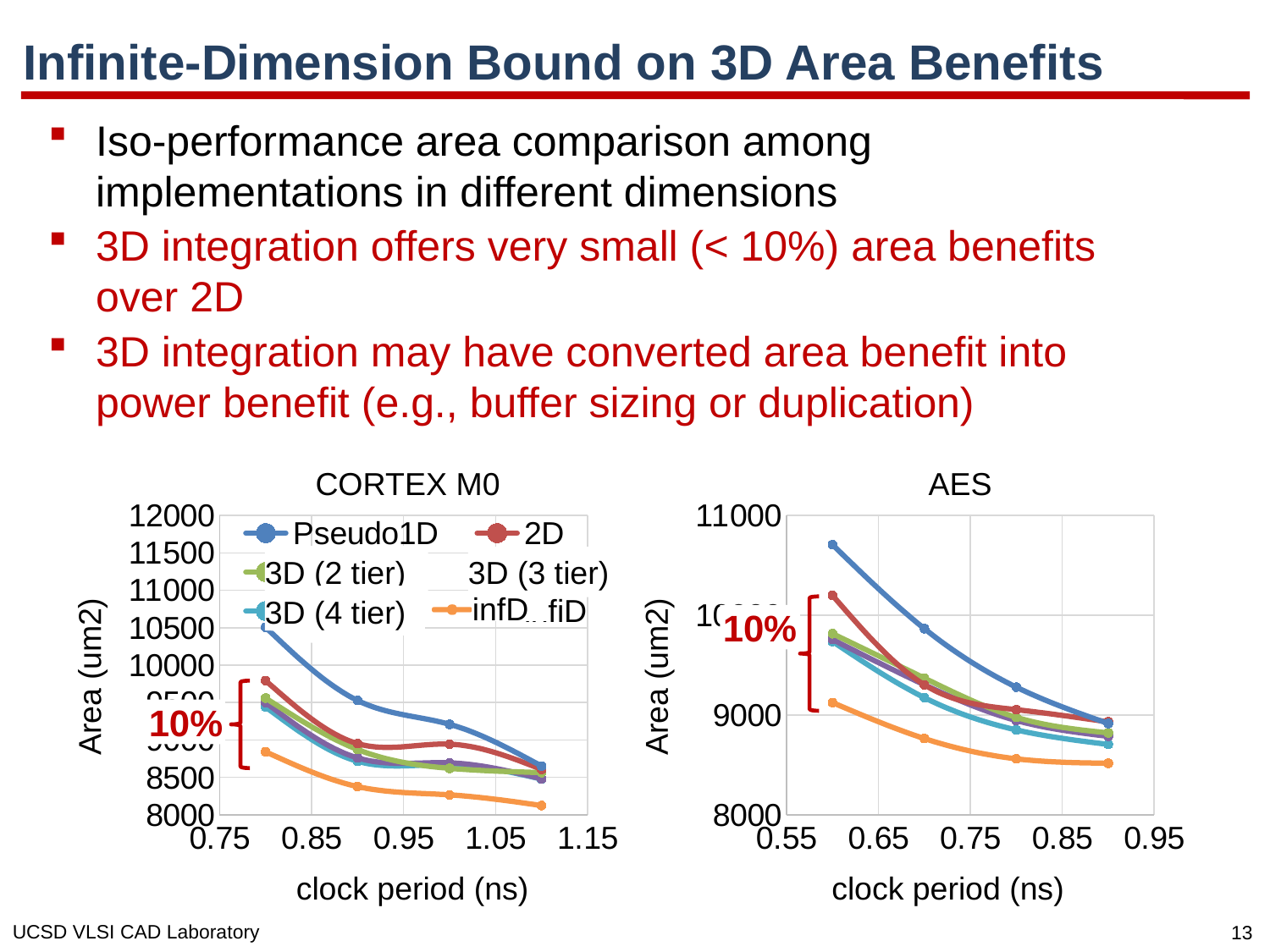
How many series does the legend on the CORTEX M0 chart list? 6 In the CORTEX M0 chart, which series has the highest area at every clock period? Pseudo1D In the CORTEX M0 chart, at a clock period of 0.9 ns, which series has the larger area: Pseudo1D or infD? Pseudo1D In the AES chart, how does the area change as the clock period increases? It decreases What is the y-axis label on the AES chart? Area (um2) In the AES chart, which series has the lowest area at every clock period? infD In the CORTEX M0 chart, is the infD area at a clock period of 1.1 ns greater or less than 8500? less How many data points does each series have in the AES chart? 4 In the AES chart, is the Pseudo1D area at a clock period of 0.6 ns greater or less than 10500? greater In the AES chart, is the infD area at a clock period of 0.9 ns greater or less than 9000? less What kind of chart is the CORTEX M0 chart? line chart In the CORTEX M0 chart, how does the area change as the clock period increases? It decreases